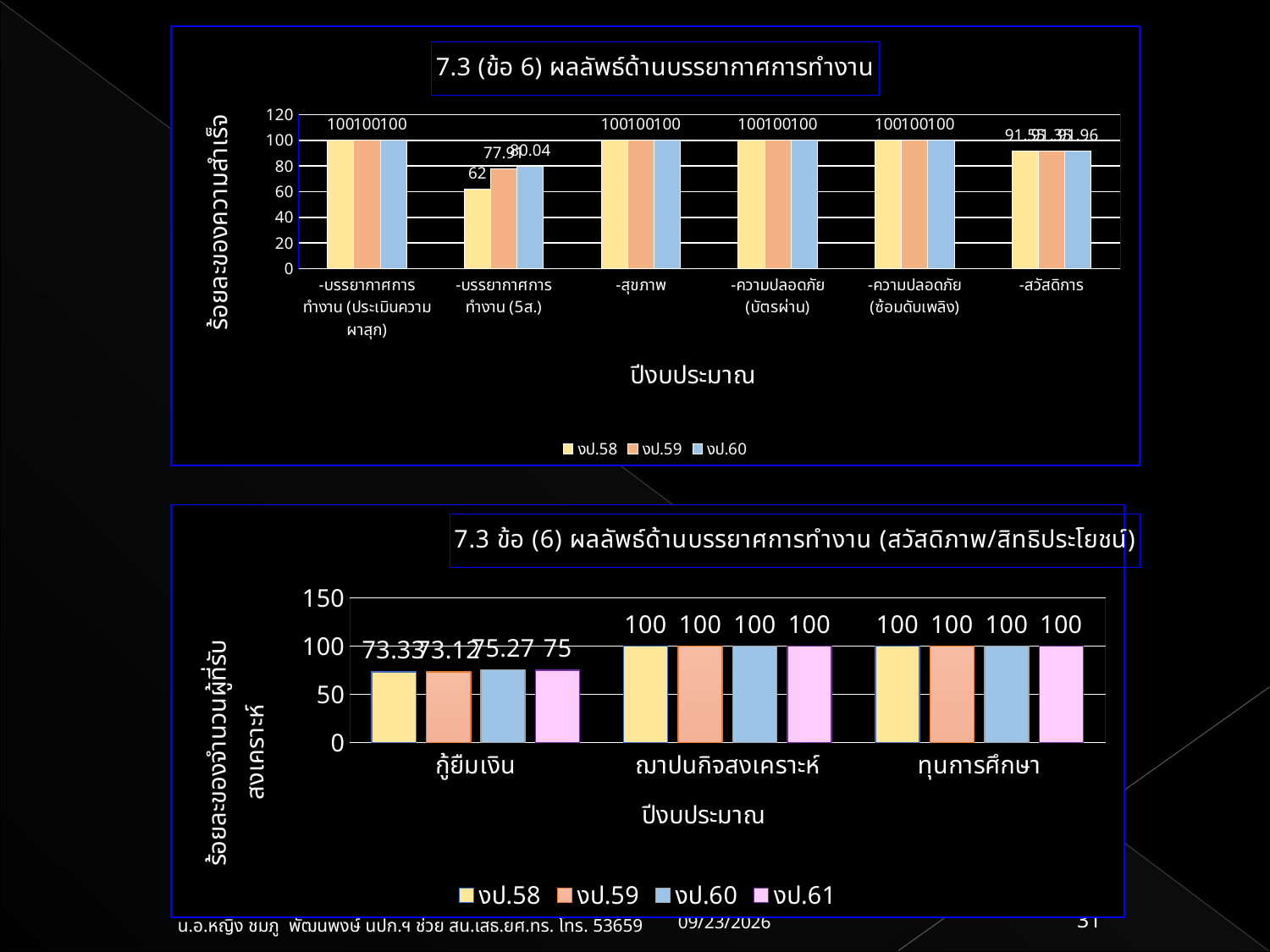
In the top chart, which category has the lowest value for งป.58? -บรรยากาศการทำงาน (5ส.) In the bottom chart, what is the value for งป.60 in the category กู้ยืมเงิน? 75.27 In the bottom chart, how many series does the legend list? 4 In the bottom chart, what is the value for งป.61 in the category กู้ยืมเงิน? 75 In the top chart, what is the value for งป.58 in the category -บรรยากาศการทำงาน (5ส.)? 62 In the top chart, how many categories are shown on the x axis? 6 What type of chart is the bottom chart? Bar chart In the top chart, what is the value for งป.59 in the category -สุขภาพ? 100 In the top chart, what is the value for งป.60 in the category -บรรยากาศการทำงาน (5ส.)? 80.04 In the top chart, how many series does the legend list? 3 In the bottom chart, what is the difference between the งป.61 value for ทุนการศึกษา and the งป.61 value for กู้ยืมเงิน? 25 In the top chart, is the value for งป.59 in -สวัสดิการ greater or less than 80? greater